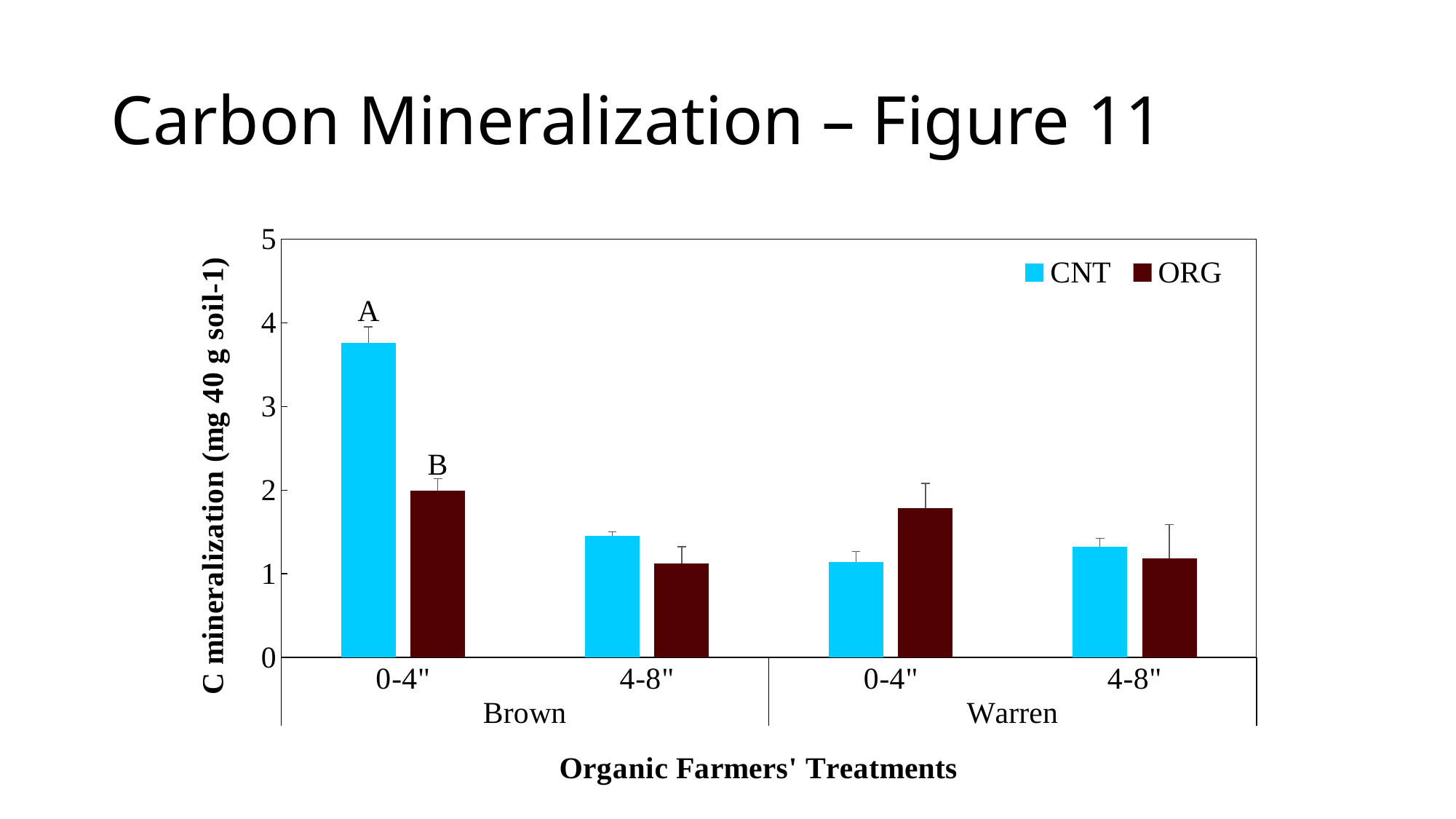
Is the ORG value for Brown 0-4" greater or less than 1? greater How many series does the legend list? 2 How many depth categories are shown along the x axis in total? 4 For Brown 0-4", which is larger, CNT or ORG? CNT For Warren 0-4", which is larger, CNT or ORG? ORG Which bar is the highest in the chart? CNT at Brown 0-4" Is the CNT value for Brown 4-8" greater or less than 2? less What is the x-axis title of the chart? Organic Farmers' Treatments What are the two series named in the legend? CNT and ORG What kind of chart is shown on the slide? bar chart Is the CNT value for Brown 0-4" greater or less than 3? greater